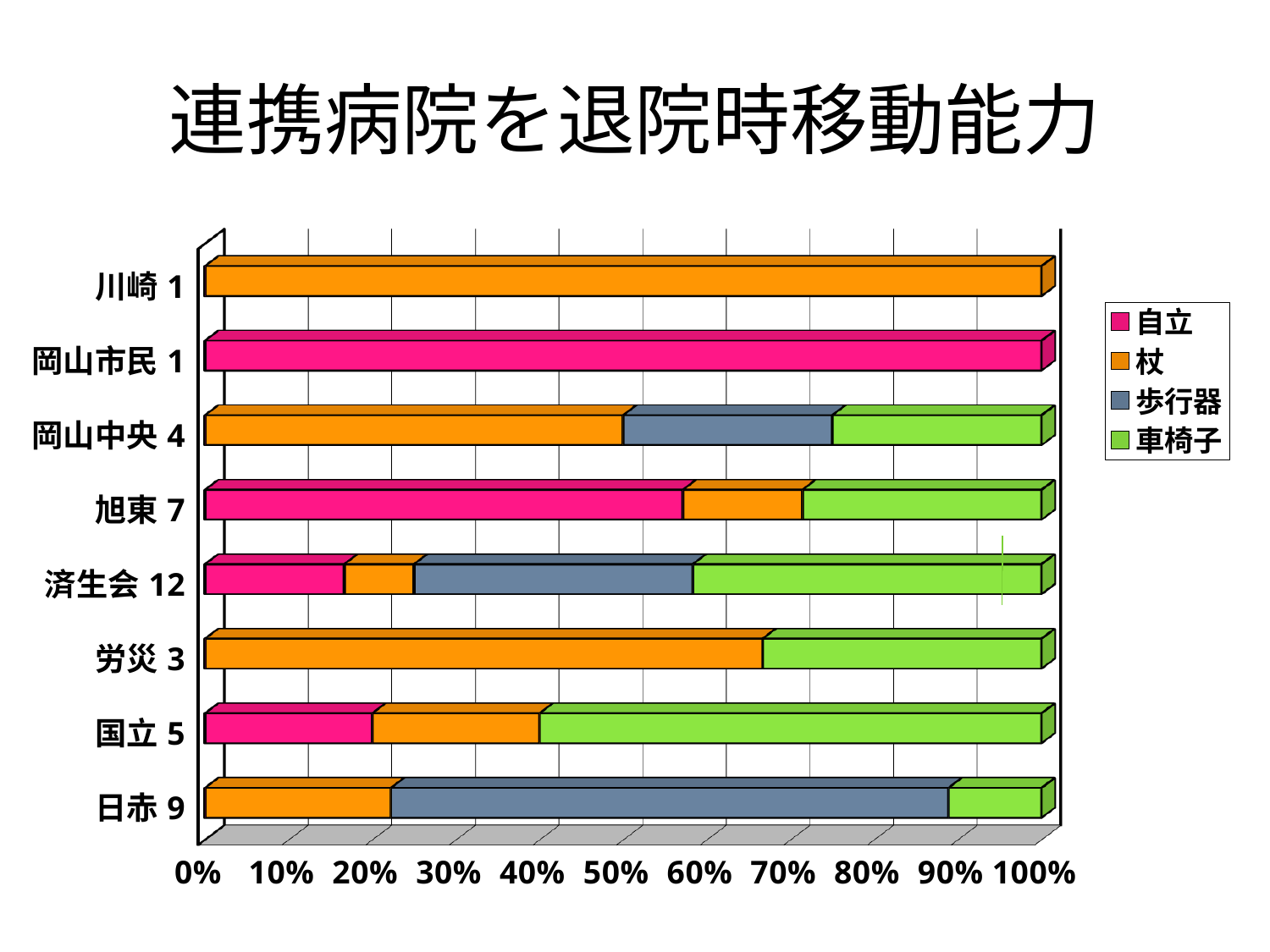
What kind of chart is shown on the slide? bar chart Which has the larger 自立 share, 旭東 7 or 国立 5? 旭東 7 Is the 車椅子 share for 国立 5 greater or less than 50%? greater Is the 自立 share for 済生会 12 greater or less than 20%? less Which has the larger 歩行器 share, 日赤 9 or 岡山中央 4? 日赤 9 Is the 杖 share for 岡山中央 4 greater or less than 40%? greater What is the title of the chart? 連携病院を退院時移動能力 How many series does the legend list? 4 Which colour represents 車椅子 in the legend? green How many hospitals (categories) are listed on the vertical axis? 8